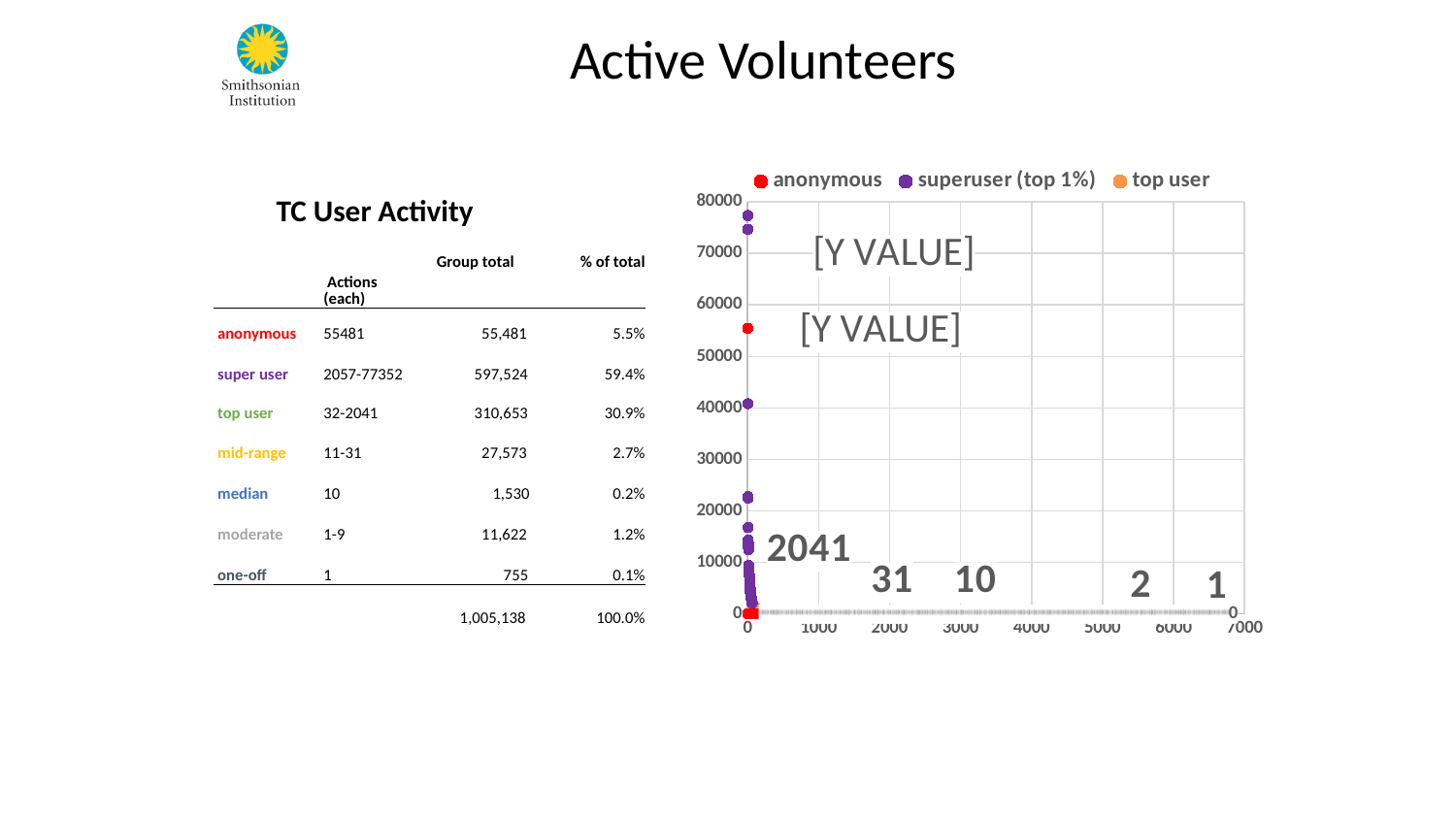
What is the smallest numeric data label printed inside the plot area of the scatter chart? 1 What kind of chart is shown on the right side of the slide? scatter chart Is the y value of the topmost purple point in the scatter chart greater or less than 70000? greater Is the y value of the red anonymous point in the scatter chart greater or less than 60000? less What is the largest numeric data label printed inside the plot area of the scatter chart? 2041 How many series does the legend of the scatter chart list? 3 What is the highest tick value shown on the y axis of the scatter chart? 80000 Which series in the scatter chart has the point with the highest y value? superuser (top 1%) What colour are the markers for the anonymous series in the scatter chart? red What are the three series named in the legend of the scatter chart? anonymous, superuser (top 1%), top user Is the y value of the red anonymous point in the scatter chart greater or less than 50000? greater